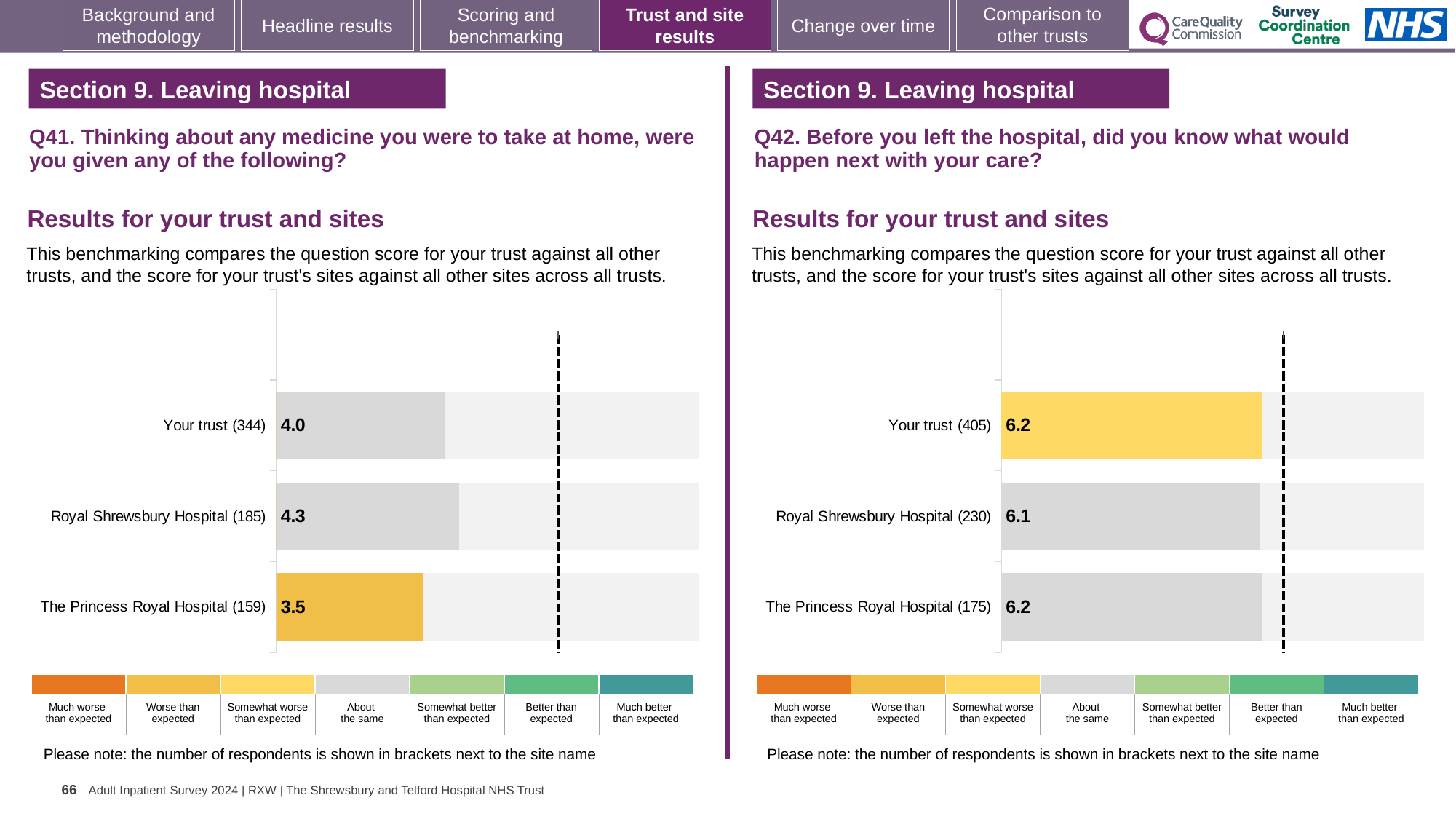
What type of chart is used for the Q41 results on the left? Bar chart In the Q41 chart on the left, which site or trust has the highest score? Royal Shrewsbury Hospital In the Q42 chart on the right, what is the score for Your trust? 6.2 In the Q41 chart on the left, what is the score for Your trust? 4.0 In the Q41 chart on the left, what is the score for Royal Shrewsbury Hospital? 4.3 In the Q41 chart on the left, how many respondents are shown in brackets for The Princess Royal Hospital? 159 In the Q42 chart on the right, what is the score for Royal Shrewsbury Hospital? 6.1 How many bars are plotted in the Q42 chart on the right? 3 In the Q41 chart on the left, what is the score for The Princess Royal Hospital? 3.5 In the Q41 chart on the left, what is the difference between the scores for Royal Shrewsbury Hospital and The Princess Royal Hospital? 0.8 In the Q42 chart on the right, what is the difference between the scores for Your trust and Royal Shrewsbury Hospital? 0.1 In the Q41 chart on the left, which site or trust has the lowest score? The Princess Royal Hospital